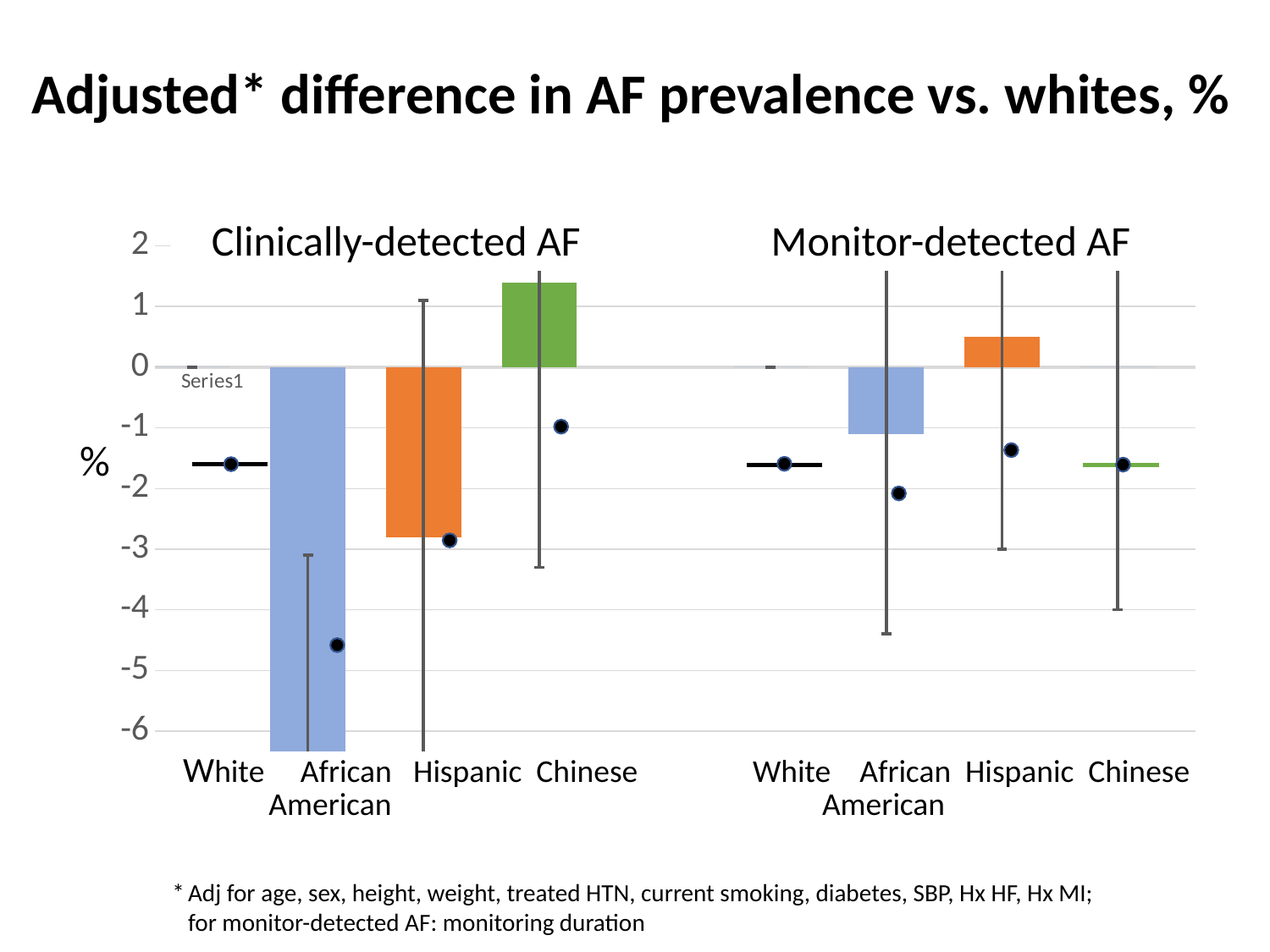
Is the Clinically-detected AF value for African American greater or less than -5? less Which is lower: the Hispanic bar in the Clinically-detected AF group or the Hispanic bar in the Monitor-detected AF group? Clinically-detected AF What kind of chart is shown on the slide? bar chart How many racial/ethnic categories are shown in each group of the chart? 4 In the Clinically-detected AF group, which category has the lowest bar? African American What is the title of the slide's chart? Adjusted* difference in AF prevalence vs. whites, % Is the Monitor-detected AF value for Hispanic greater or less than 1? less In the Clinically-detected AF group, which category has the highest bar? Chinese What are the two groups of bars in the chart labelled? Clinically-detected AF and Monitor-detected AF In the Monitor-detected AF group, which category has the lowest bar? African American Is the Clinically-detected AF value for Chinese greater or less than 1? greater In the Monitor-detected AF group, which category has the highest bar? Hispanic